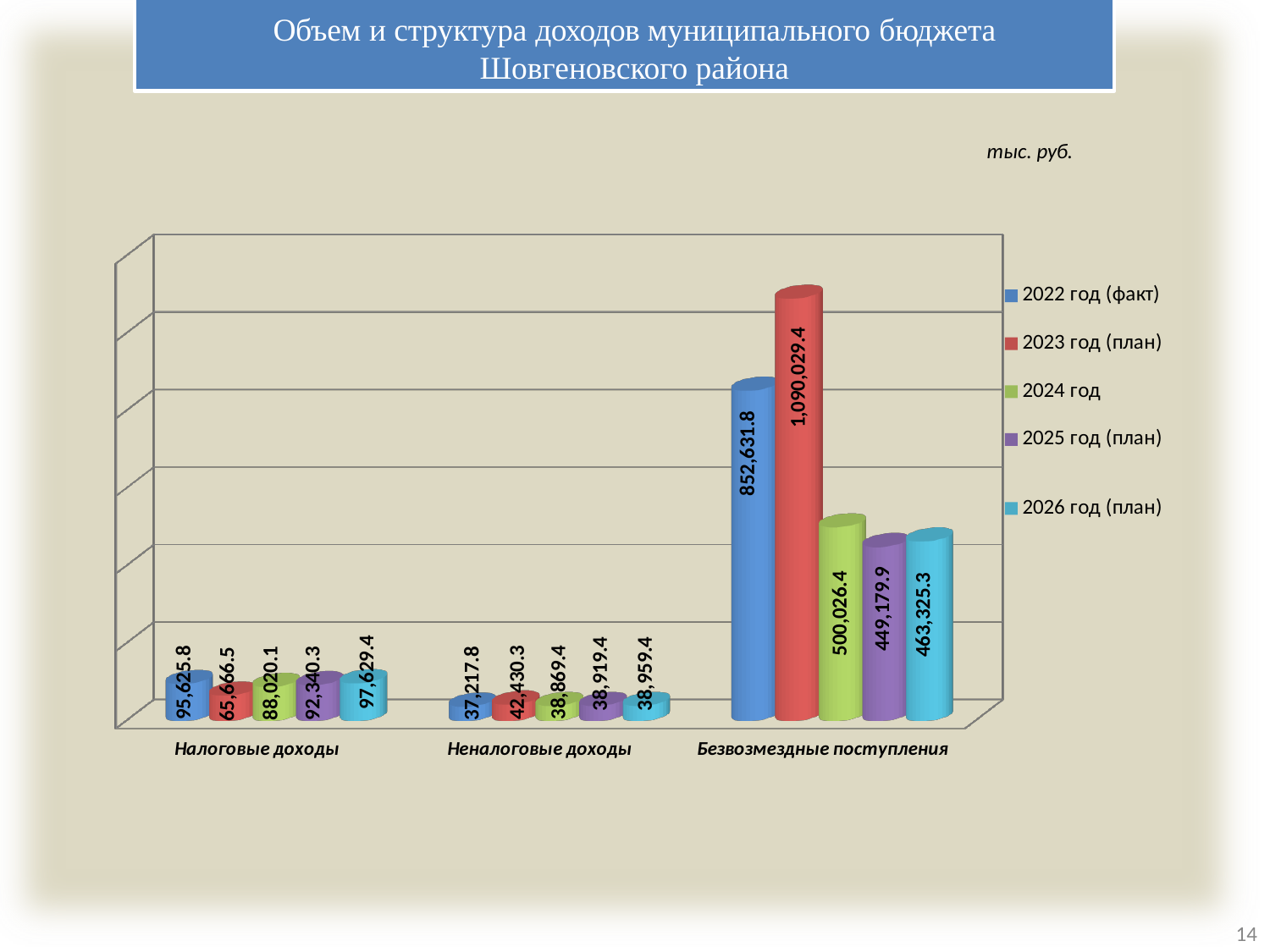
Which series has the lowest value for Налоговые доходы? 2023 год (план) What is the value for Безвозмездные поступления in 2023 год (план)? 1,090,029.4 How many series does the legend list? 5 What is the difference between the 2023 год (план) and 2022 год (факт) values for Безвозмездные поступления? 237,397.6 How many categories are shown on the x axis? 3 What is the value for Налоговые доходы in 2022 год (факт)? 95,625.8 Which series has the highest value for Безвозмездные поступления? 2023 год (план) What is the value for Неналоговые доходы in 2026 год (план)? 38,959.4 What colour represents 2024 год in the legend? Green What type of chart is shown on the slide? Bar chart What unit is indicated above the chart? тыс. руб. Which is larger for Неналоговые доходы: the 2023 год (план) value or the 2022 год (факт) value? 2023 год (план)